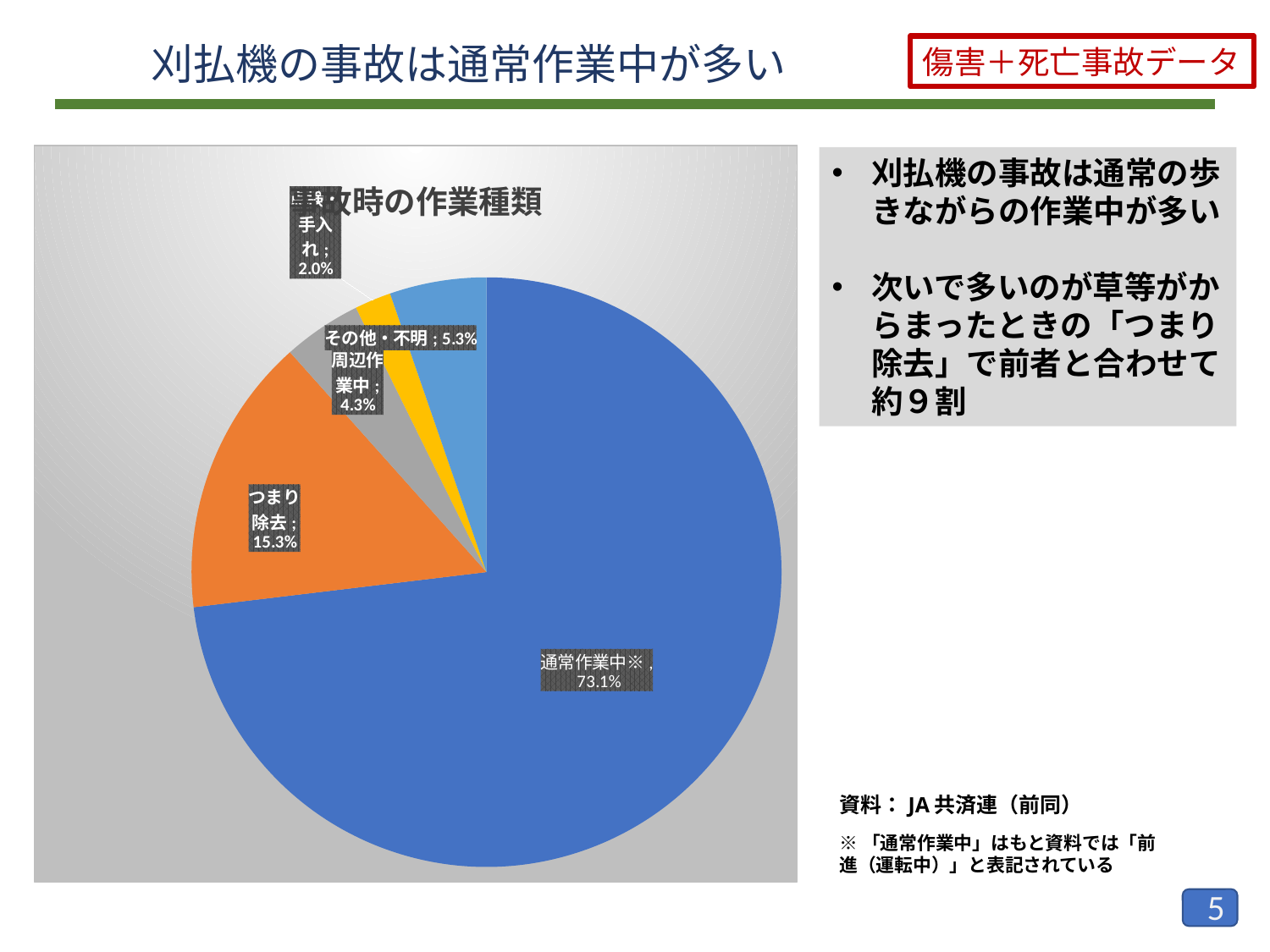
How many percentage points larger is 通常作業中※ than つまり除去? 57.8 percentage points Which is larger, その他・不明 or 周辺作業中? その他・不明 Which category has the largest slice of the pie? 通常作業中※ What percentage is shown for つまり除去? 15.3% What is the combined share of 通常作業中※ and つまり除去? 88.4% What percentage is shown for その他・不明? 5.3% What share of the pie does 通常作業中※ account for? 73.1% What percentage is shown for 周辺作業中? 4.3% Which category has the smallest slice of the pie? 手入れ What kind of chart is shown on the slide? Pie chart What percentage is shown for 手入れ? 2.0% How many slices does the pie chart have? 5